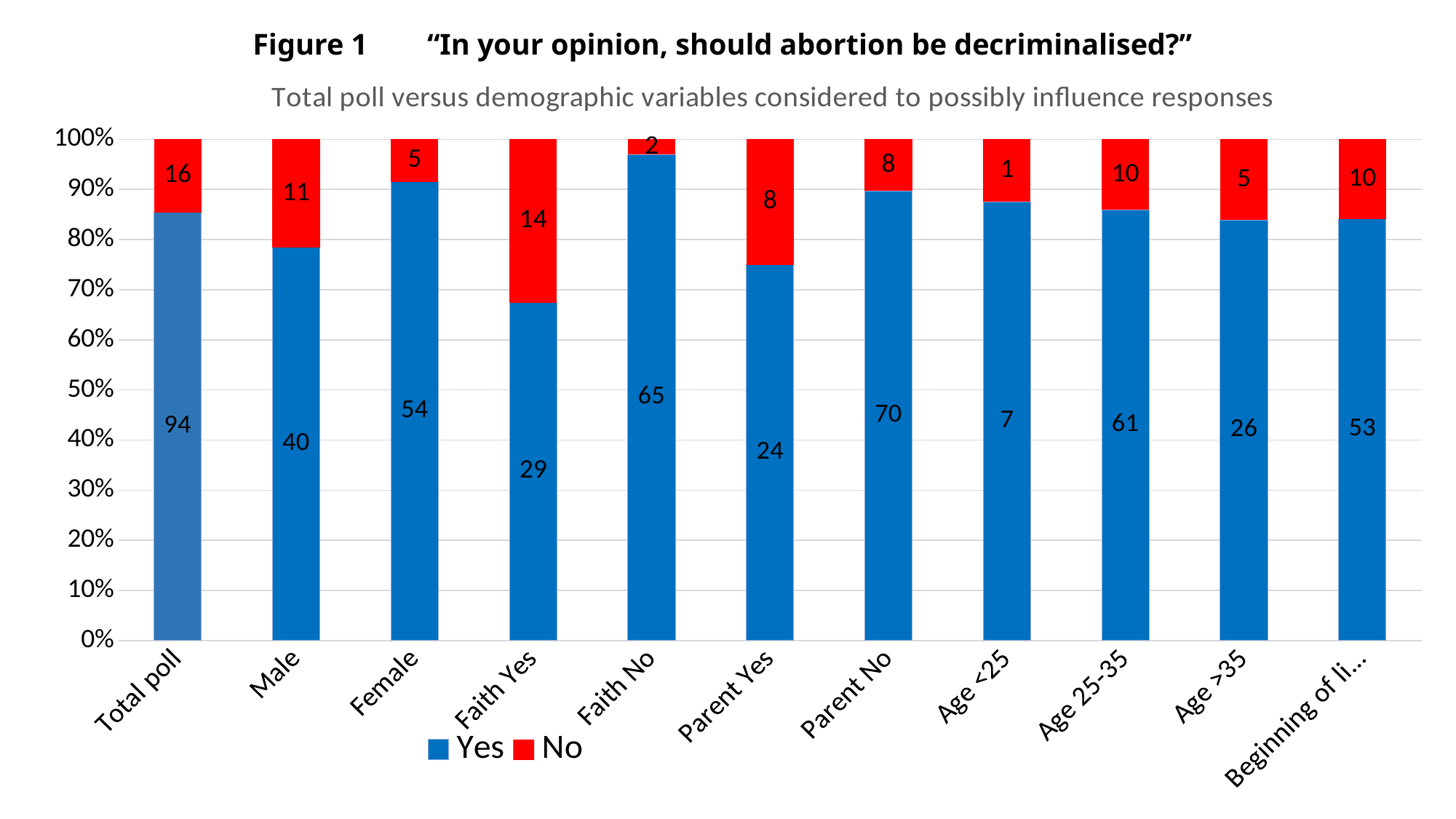
What is the difference between the 'Yes' counts for Male and Female? 14 Is the 'Yes' share of the Faith Yes bar greater or less than 70%? less How many 'No' responses are shown for the Faith Yes category? 14 What is the total number of responses (Yes plus No) for the Total poll bar? 110 What kind of chart is shown on the slide? Stacked bar chart Is the 'Yes' share of the Female bar greater or less than 90%? greater How many 'Yes' responses are shown for the Female category? 54 What is the 'Yes' value for the Parent No category? 70 How many categories are shown on the x axis? 11 Which has more 'No' responses, Faith Yes or Faith No? Faith Yes Which category has the highest 'Yes' count? Total poll Which category has the lowest 'Yes' count? Age <25